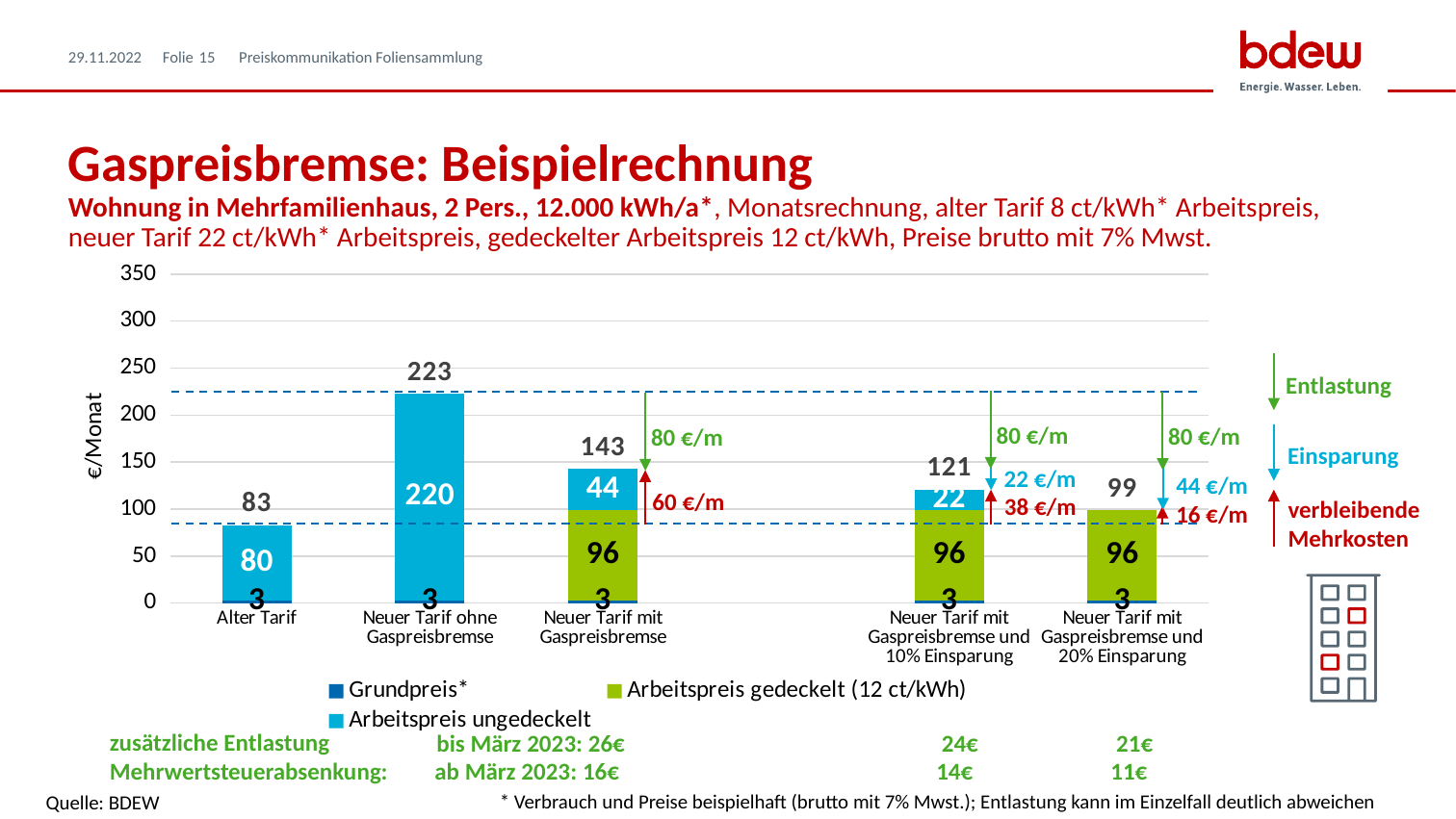
Which category has the highest total bar? Neuer Tarif ohne Gaspreisbremse How many categories are shown on the x axis? 5 Which category has the lowest total bar? Alter Tarif What is the total value shown above the bar for "Neuer Tarif ohne Gaspreisbremse"? 223 What is the value of the "Arbeitspreis ungedeckelt" segment in the "Neuer Tarif mit Gaspreisbremse" bar? 44 What is the label of the y axis? €/Monat What is the total value shown above the bar for "Alter Tarif"? 83 What is the value of the "Arbeitspreis gedeckelt (12 ct/kWh)" segment in the "Neuer Tarif mit Gaspreisbremse und 10% Einsparung" bar? 96 What kind of chart is shown on the slide? Stacked bar chart Which total is larger: "Neuer Tarif mit Gaspreisbremse und 10% Einsparung" or "Neuer Tarif mit Gaspreisbremse und 20% Einsparung"? Neuer Tarif mit Gaspreisbremse und 10% Einsparung What is the difference between the totals for "Neuer Tarif ohne Gaspreisbremse" and "Neuer Tarif mit Gaspreisbremse"? 80 How many series does the legend list? 3